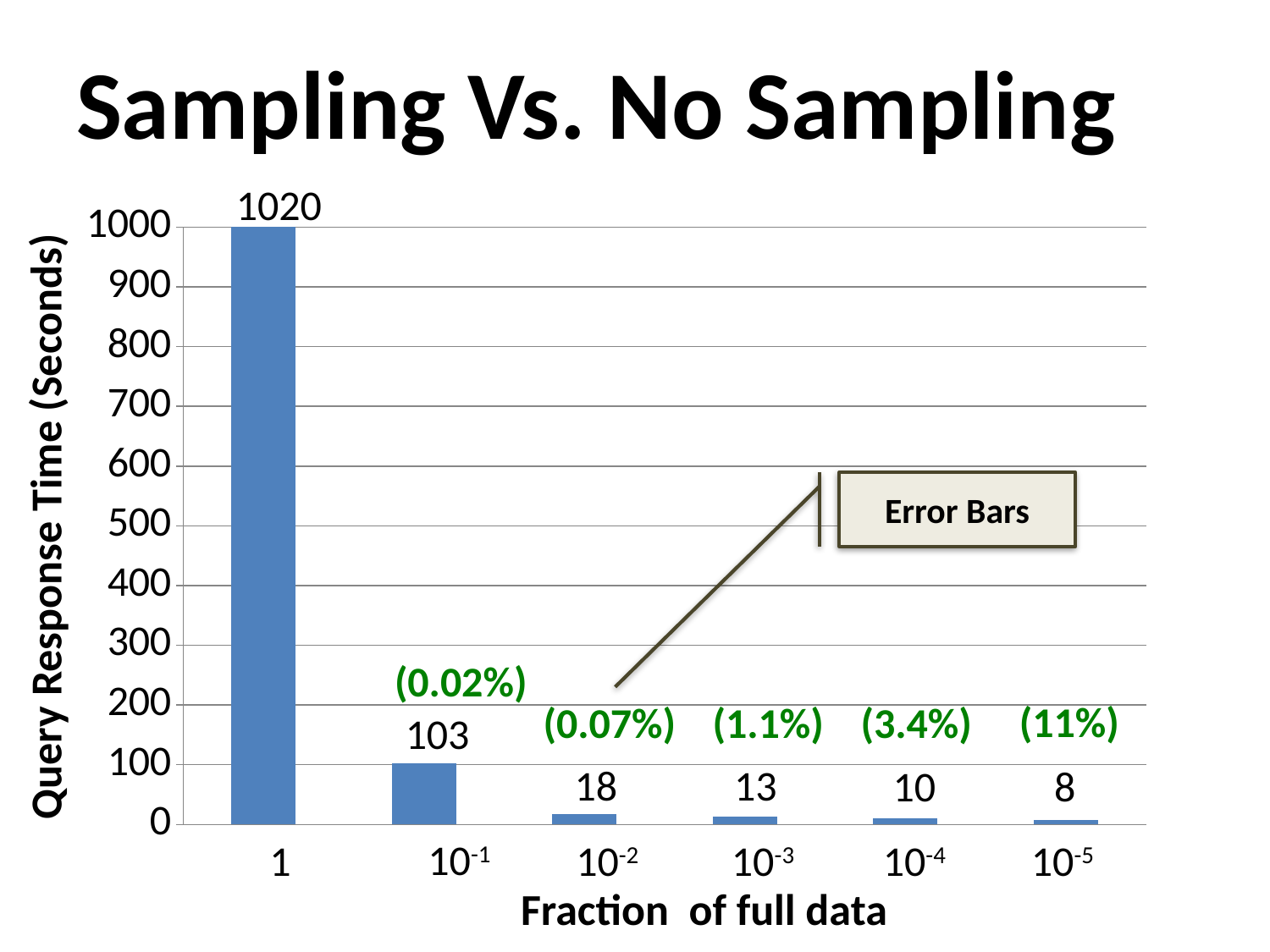
What is the label of the y axis? Query Response Time (Seconds) What is the query response time for fraction 1 (full data)? 1020 What is the query response time for fraction 10^-1? 103 Which fraction of full data has the lowest query response time? 10^-5 Which has a larger query response time, fraction 10^-3 or fraction 10^-4? 10^-3 What is the query response time for fraction 10^-5? 8 How many fractions of full data are shown on the x axis? 6 What is the difference in query response time between fraction 10^-2 and fraction 10^-3? 5 Do the query response times rise or fall as the fraction of full data decreases along the x axis? Fall Which fraction of full data has the highest query response time? 1 What is the difference in query response time between fraction 1 and fraction 10^-1? 917 What kind of chart is shown on the slide? Bar chart